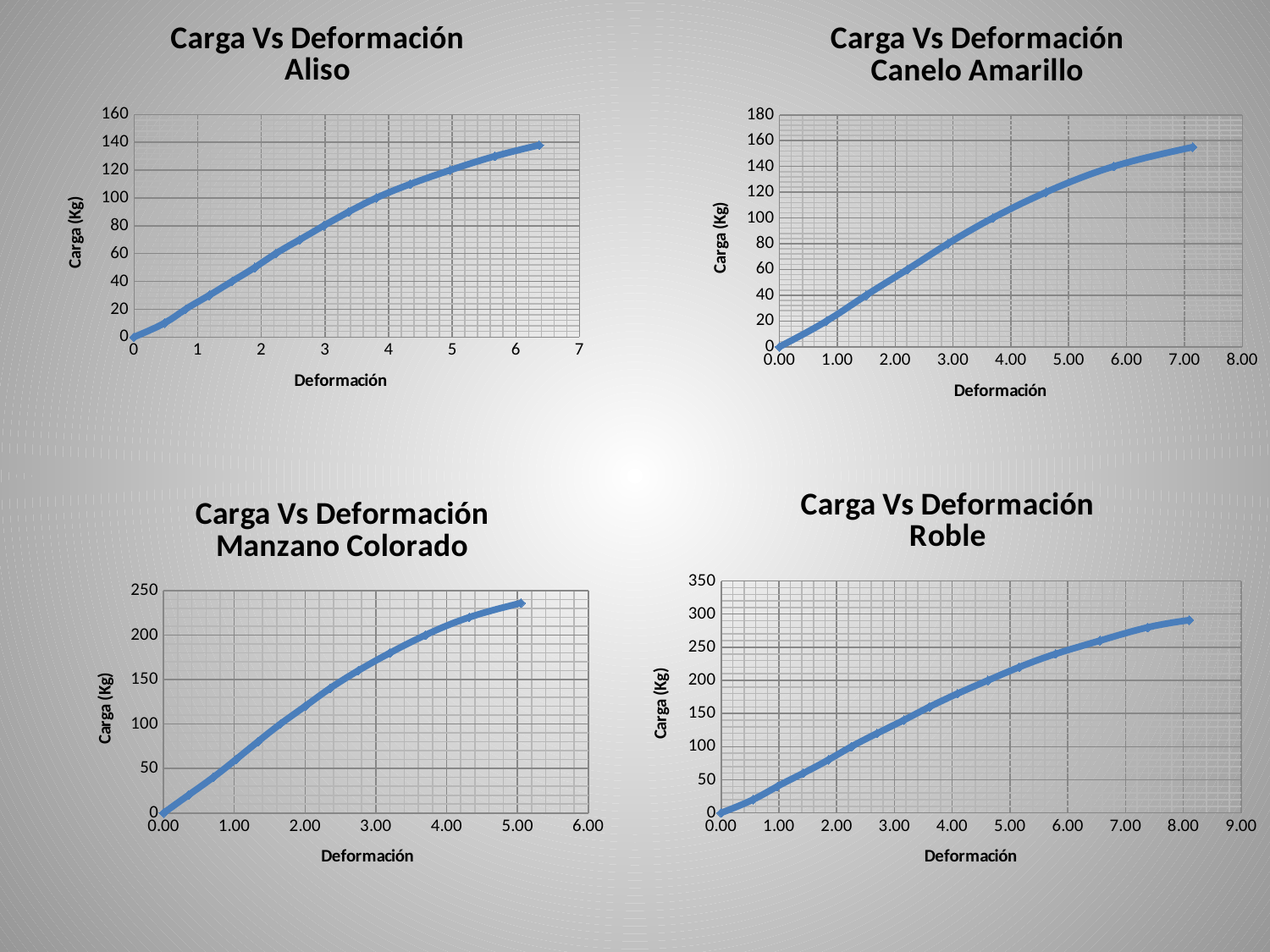
In the 'Carga Vs Deformación Aliso' chart, do the Carga values rise or fall as Deformación increases? rise In the 'Carga Vs Deformación Aliso' chart, is the highest Carga value reached greater or less than 120? greater In the 'Carga Vs Deformación Manzano Colorado' chart, is the highest Carga value reached greater or less than 200? greater Which of the four charts has a curve that reaches the highest Carga value? Carga Vs Deformación Roble In the 'Carga Vs Deformación Roble' chart, do the Carga values rise or fall as Deformación increases? rise What kind of chart is the 'Carga Vs Deformación Aliso' chart? line chart In the 'Carga Vs Deformación Roble' chart, is the Carga value at Deformación 4.00 greater or less than 150? greater How many charts are shown on the slide? 4 What is the title of the vertical axis in the 'Carga Vs Deformación Canelo Amarillo' chart? Carga (Kg)